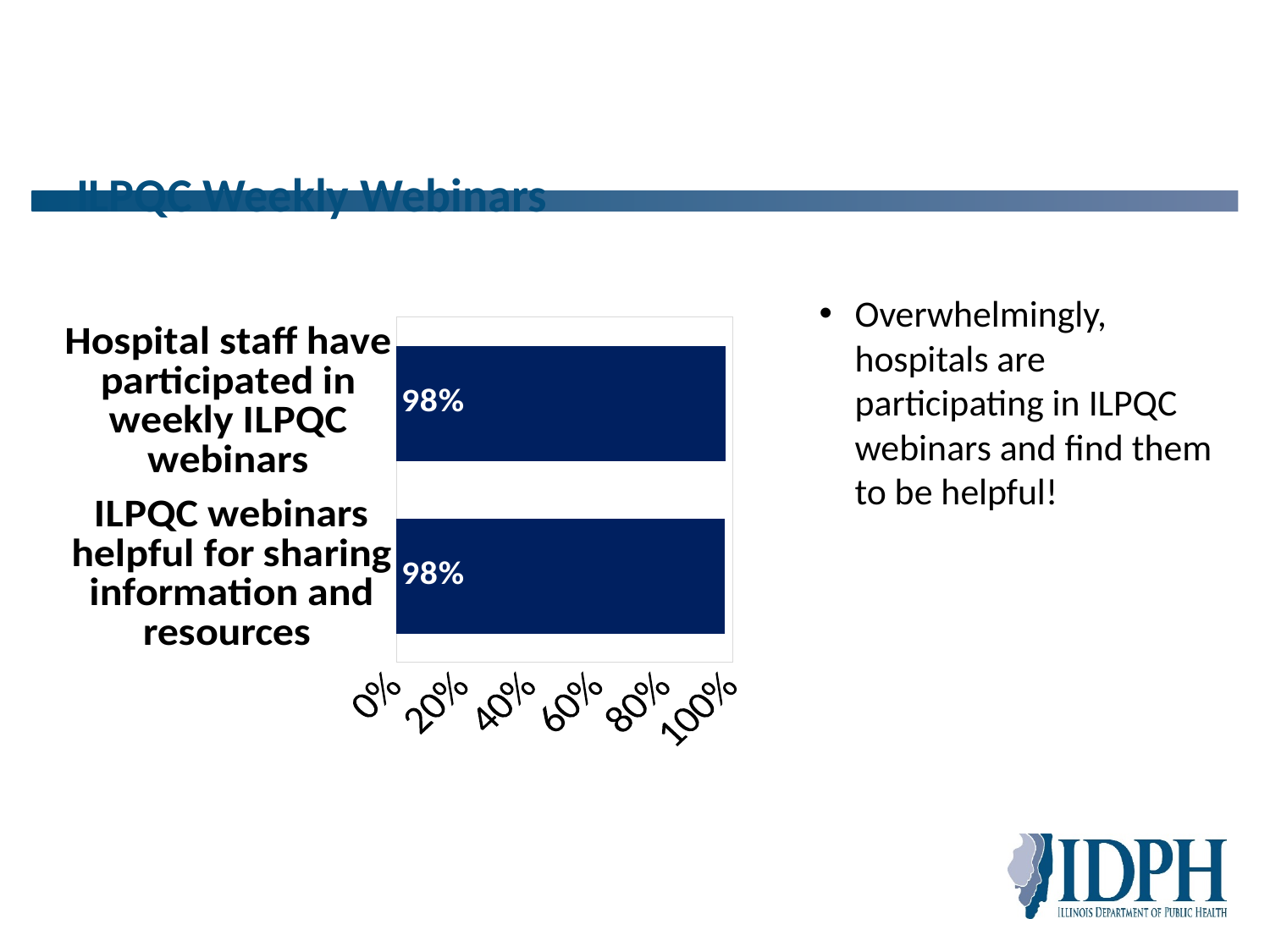
Are the bars in the chart oriented horizontally or vertically? Horizontally Do the two categories in the chart have the same value? Yes What is the value for "ILPQC webinars helpful for sharing information and resources"? 98% What is the value for "Hospital staff have participated in weekly ILPQC webinars"? 98% Is the value for "ILPQC webinars helpful for sharing information and resources" greater or less than 60%? greater How many categories are plotted in the chart? 2 What kind of chart is shown on the slide? Bar chart Is the value for "Hospital staff have participated in weekly ILPQC webinars" greater or less than 80%? greater What is the highest tick label shown on the value axis of the chart? 100% What is the difference between the value for "Hospital staff have participated in weekly ILPQC webinars" and the value for "ILPQC webinars helpful for sharing information and resources"? 0%